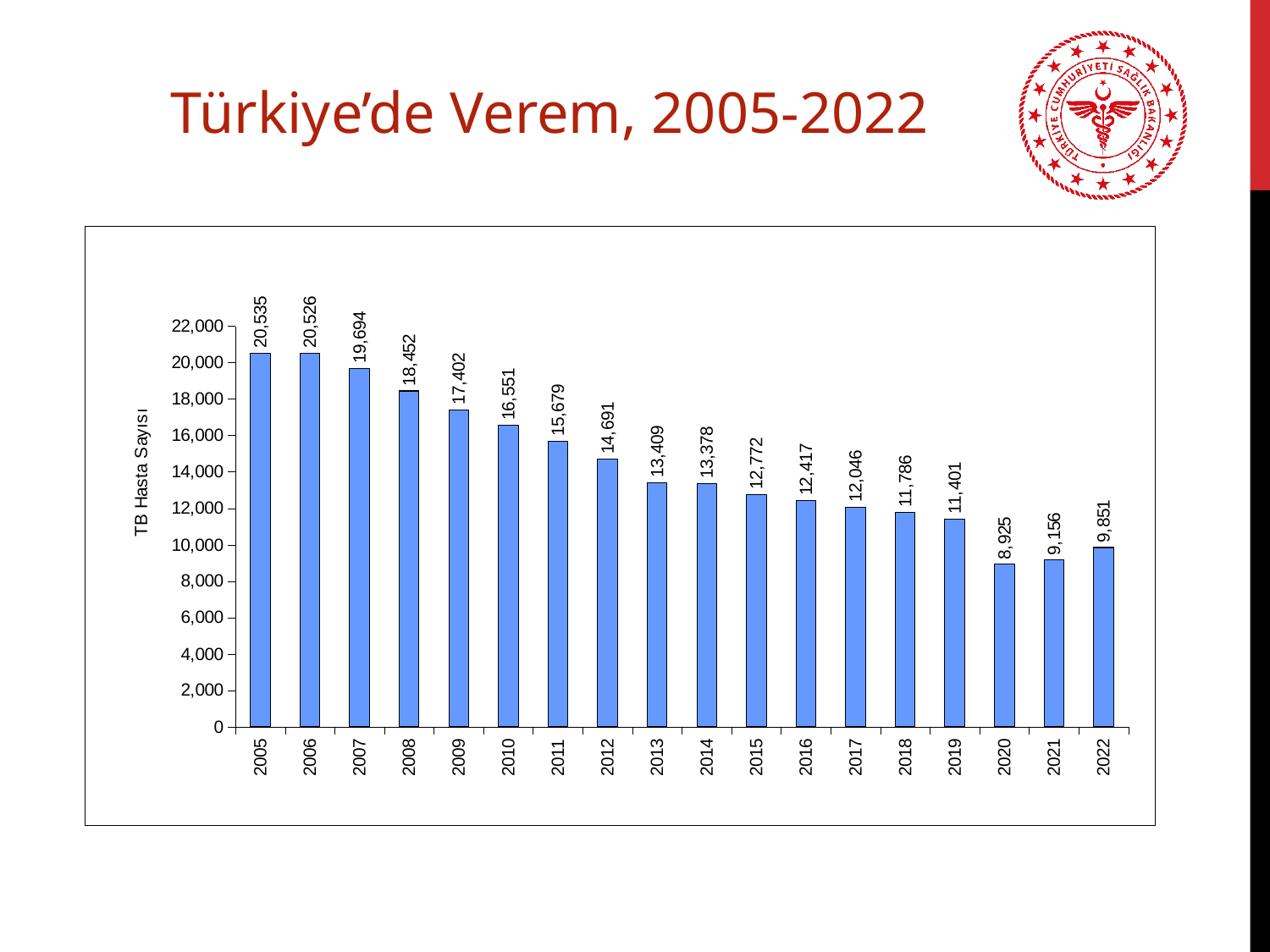
Is the value for 2012 greater or less than 14,000? greater What is the difference between the values for 2019 and 2020? 2,476 What is the value for 2013? 13,409 How many years are shown on the x axis? 18 What is the label on the y axis? TB Hasta Sayısı What kind of chart is this? bar chart What is the value for 2020? 8,925 What is the value for 2005? 20,535 What is the difference between the values for 2005 and 2022? 10,684 Which is larger, the value for 2021 or the value for 2022? 2022 Which year has the lowest value? 2020 Which year has the highest value? 2005